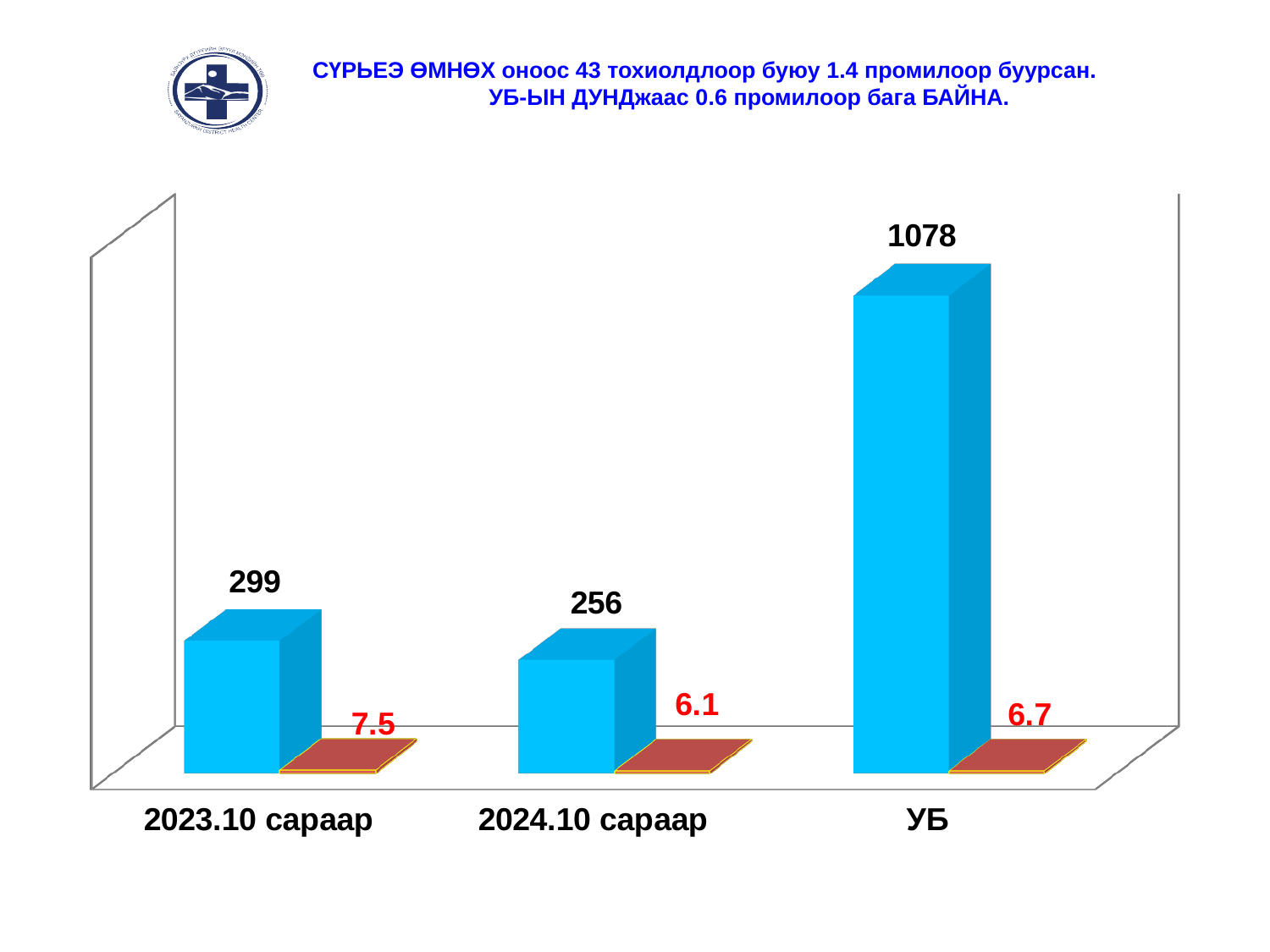
What is the difference between the blue bar values for 2023.10 сараар and 2024.10 сараар? 43 What is the red value shown for 2023.10 сараар? 7.5 What is the value of the blue bar for 2024.10 сараар? 256 How many categories are shown on the x axis? 3 What is the value of the blue bar for 2023.10 сараар? 299 Which red value is larger, 2024.10 сараар or УБ? УБ What is the value of the blue bar for УБ? 1078 Does the blue bar value rise or fall from 2023.10 сараар to 2024.10 сараар? Fall Which category has the lowest blue bar? 2024.10 сараар What kind of chart is shown on the slide? Bar chart What is the red value shown for УБ? 6.7 Which category has the highest blue bar? УБ